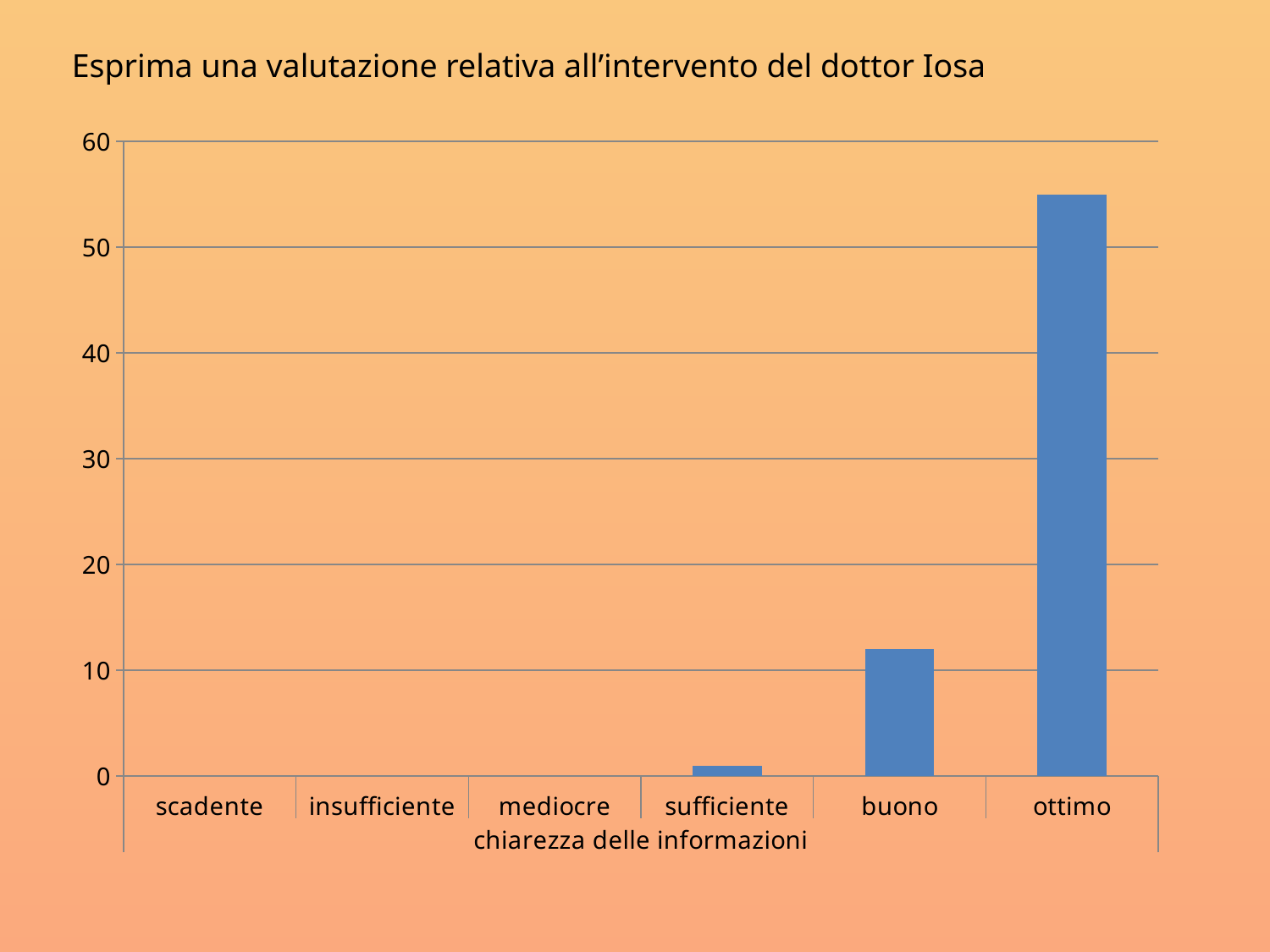
Is the value for buono greater or less than 10? greater What is the label shown under the x axis of the chart? chiarezza delle informazioni How many categories are shown on the x axis of the chart? 6 Which has the larger value, buono or ottimo? ottimo Is the value for ottimo greater or less than 50? greater Do the values generally rise or fall moving from scadente to ottimo along the x axis? rise Which has the larger value, sufficiente or buono? buono Is the value for ottimo greater or less than 60? less What kind of chart is shown on the slide? bar chart Which category has the highest value in the chart? ottimo